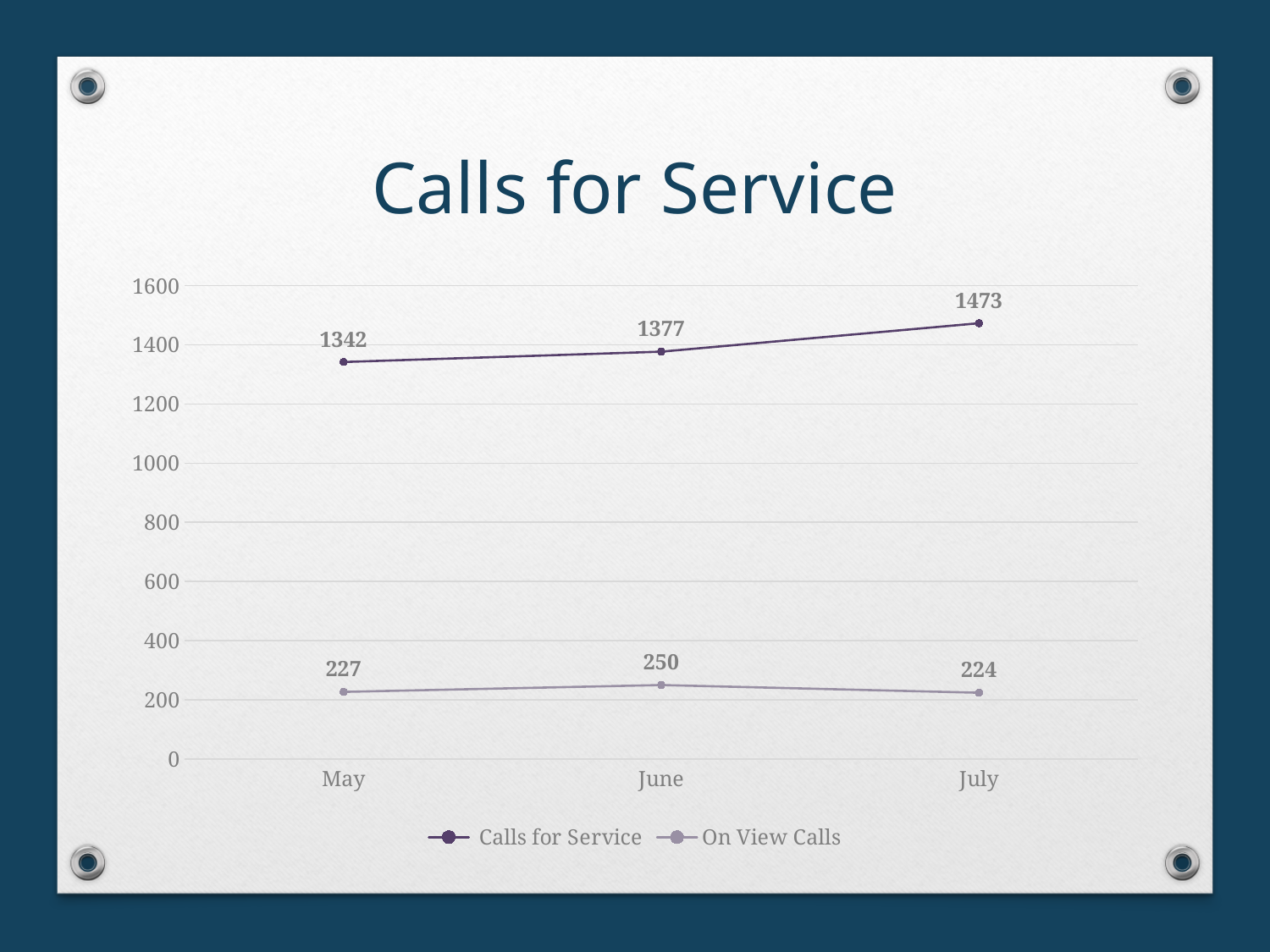
Does the Calls for Service series rise or fall from May to July? rise How many series does the legend list? 2 In which month is Calls for Service highest? July Is the value for Calls for Service in May greater or less than 1200? greater What is the title of the chart? Calls for Service What is the difference between Calls for Service in July and in May? 131 What is the value for On View Calls in July? 224 What is the value for Calls for Service in June? 1377 How many months are shown on the x axis? 3 What kind of chart is shown on the slide? line chart Which is larger: On View Calls in June or On View Calls in May? June In which month is On View Calls lowest? July